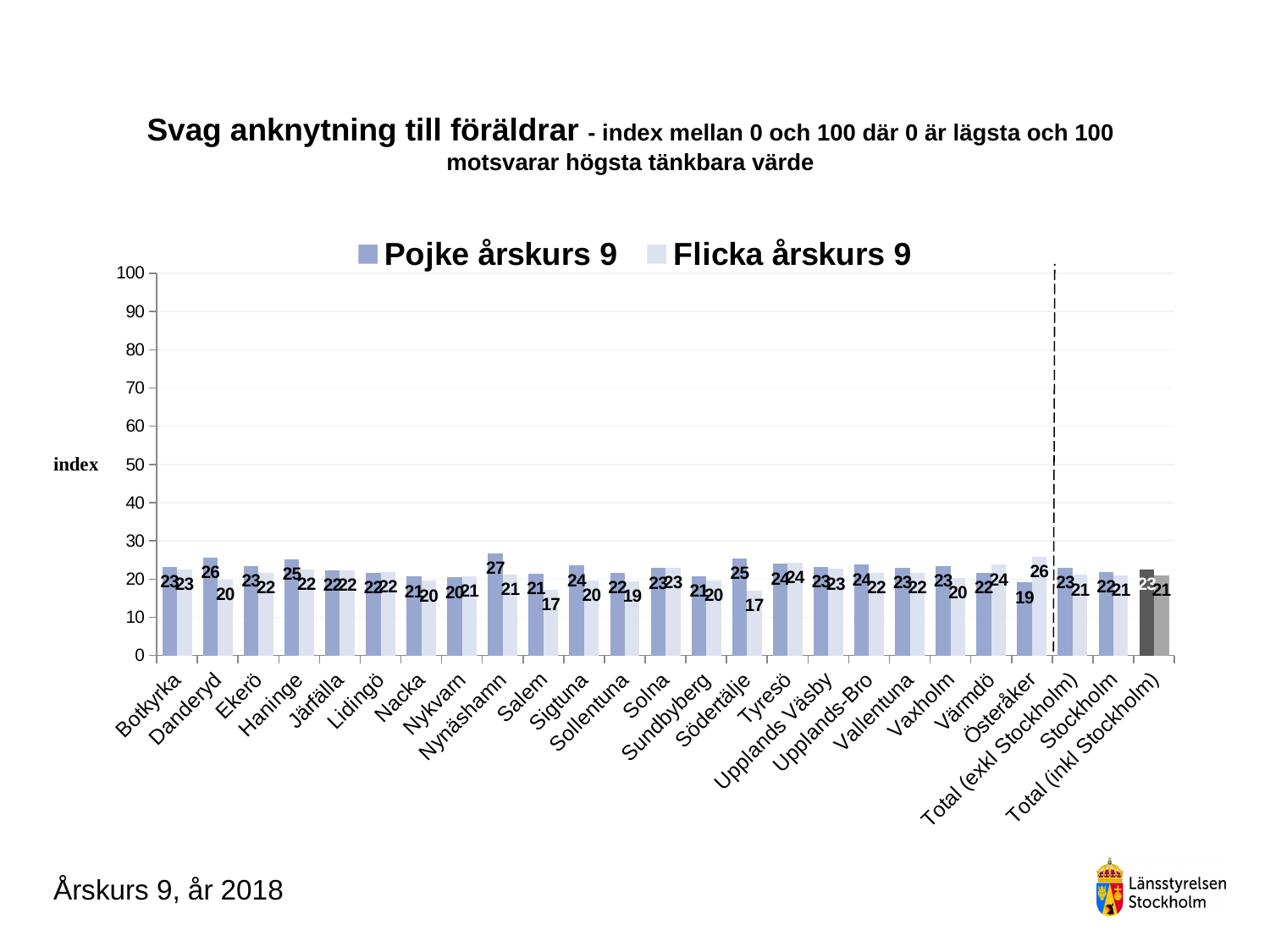
Which municipality has the highest value for Flicka årskurs 9? Österåker What is the value for Flicka årskurs 9 in Österåker? 26 Which municipality has the lowest value for Pojke årskurs 9? Österåker In Värmdö, which series has the larger value, Pojke årskurs 9 or Flicka årskurs 9? Flicka årskurs 9 Which municipality has the highest value for Pojke årskurs 9? Nynäshamn What kind of chart is shown on the slide? Bar chart How many categories are shown on the x axis? 25 In Danderyd, how much higher is the Pojke årskurs 9 value than the Flicka årskurs 9 value? 6 How many series does the legend list? 2 What is the value for Pojke årskurs 9 in Nynäshamn? 27 What is the value for Flicka årskurs 9 for Total (inkl Stockholm)? 21 In Södertälje, what is the difference between the Pojke årskurs 9 and Flicka årskurs 9 values? 8